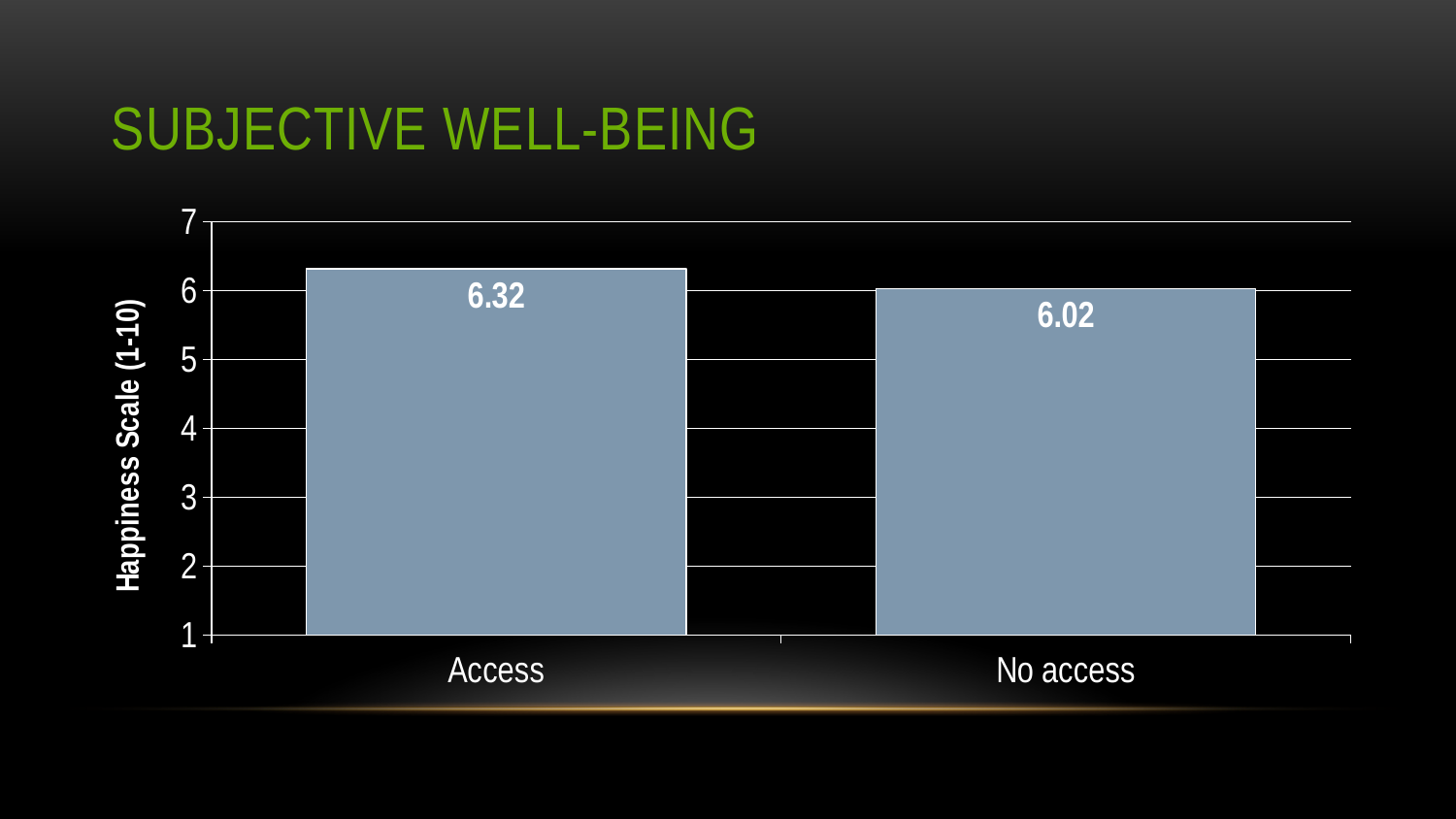
What kind of chart is shown on the slide? bar chart How many categories are shown on the x axis? 2 Which category has the lowest happiness scale value? No access Which is larger, the value for Access or the value for No access? Access What is the label of the y axis? Happiness Scale (1-10) Which category has the highest happiness scale value? Access What is the happiness scale value for Access? 6.32 Do the values rise or fall from Access to No access? fall What is the happiness scale value for No access? 6.02 What is the title of the slide? Subjective Well-Being What is the difference between the values for Access and No access? 0.30 Is the value for Access greater or less than 6? greater